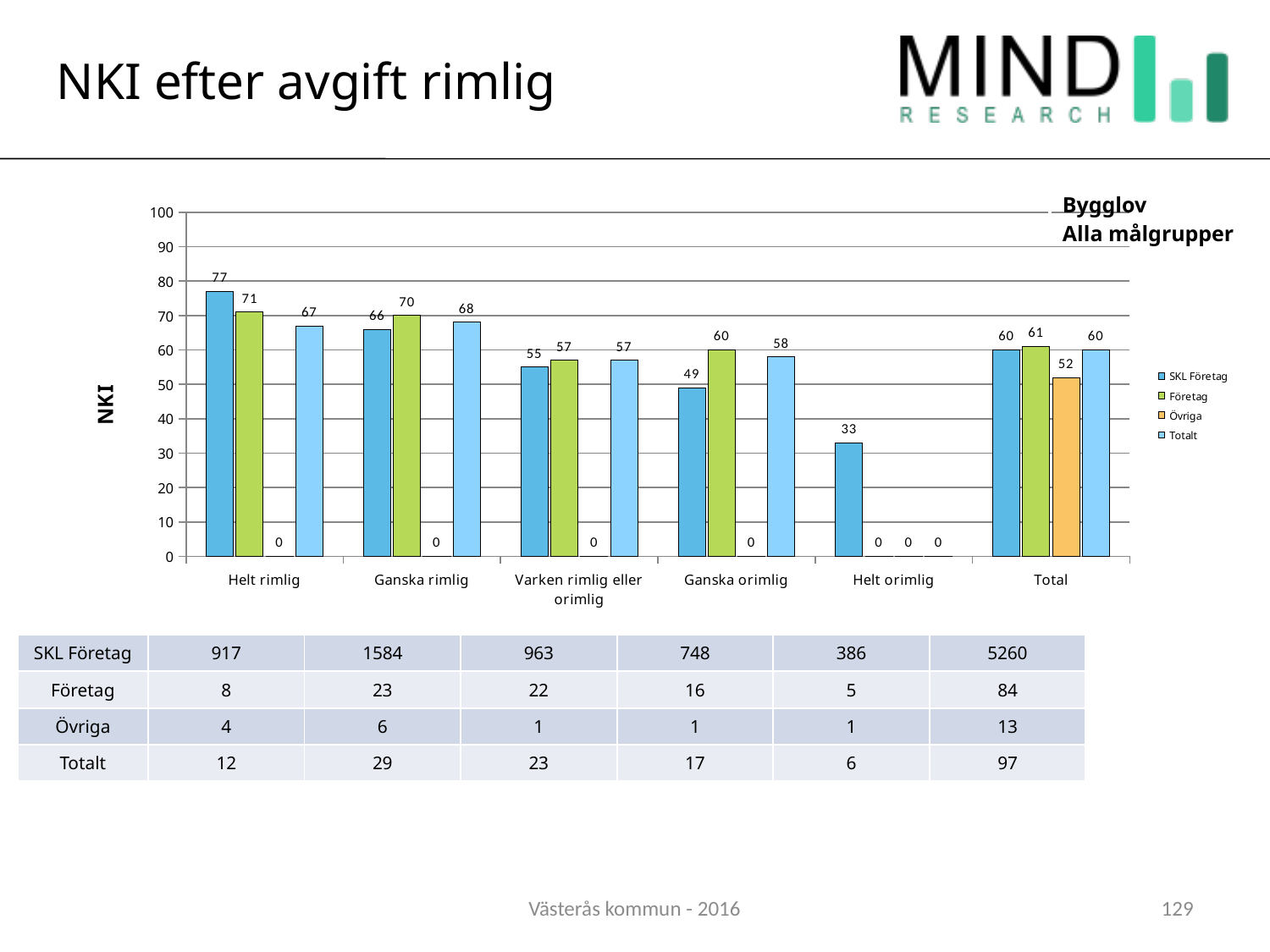
What is the NKI value for SKL Företag in the Helt rimlig category? 77 What is the NKI value for Övriga in the Total category? 52 How many categories are shown on the x axis? 6 What is the NKI value for Företag in the Ganska orimlig category? 60 Which category has the lowest SKL Företag value? Helt orimlig Which category has the highest SKL Företag value? Helt rimlig What kind of chart is shown on the slide? Bar chart Which is larger in the Ganska orimlig category: the SKL Företag value or the Företag value? Företag What is the NKI value for SKL Företag in the Helt orimlig category? 33 What is the difference between the SKL Företag values for Helt rimlig and Helt orimlig? 44 Do the SKL Företag values rise or fall from Helt rimlig to Helt orimlig? Fall How many series does the legend list? 4